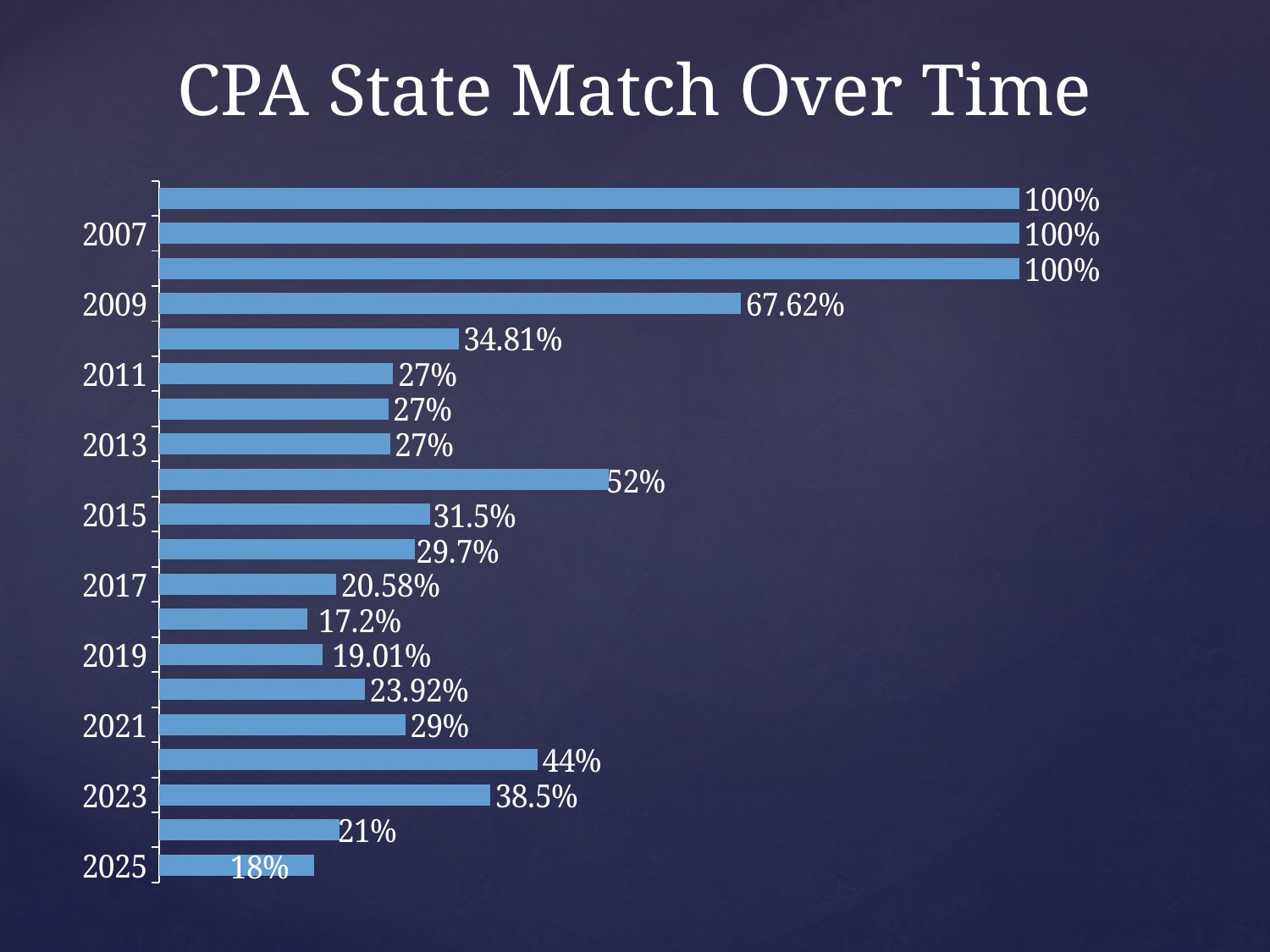
What is the CPA state match value for 2009? 67.62% Overall, do the CPA state match values rise or fall from 2007 to 2025? fall What is the CPA state match value for 2017? 20.58% What is the CPA state match value for 2015? 31.5% What is the difference between the values for 2009 and 2011? 40.62% What is the title of the chart? CPA State Match Over Time What is the CPA state match value for 2023? 38.5% What is the CPA state match value for 2025? 18% How many bars are plotted in the chart? 20 Which labeled year has the lowest CPA state match value? 2025 Which is larger, the value for 2021 or the value for 2019? 2021 What type of chart is shown on the slide? bar chart